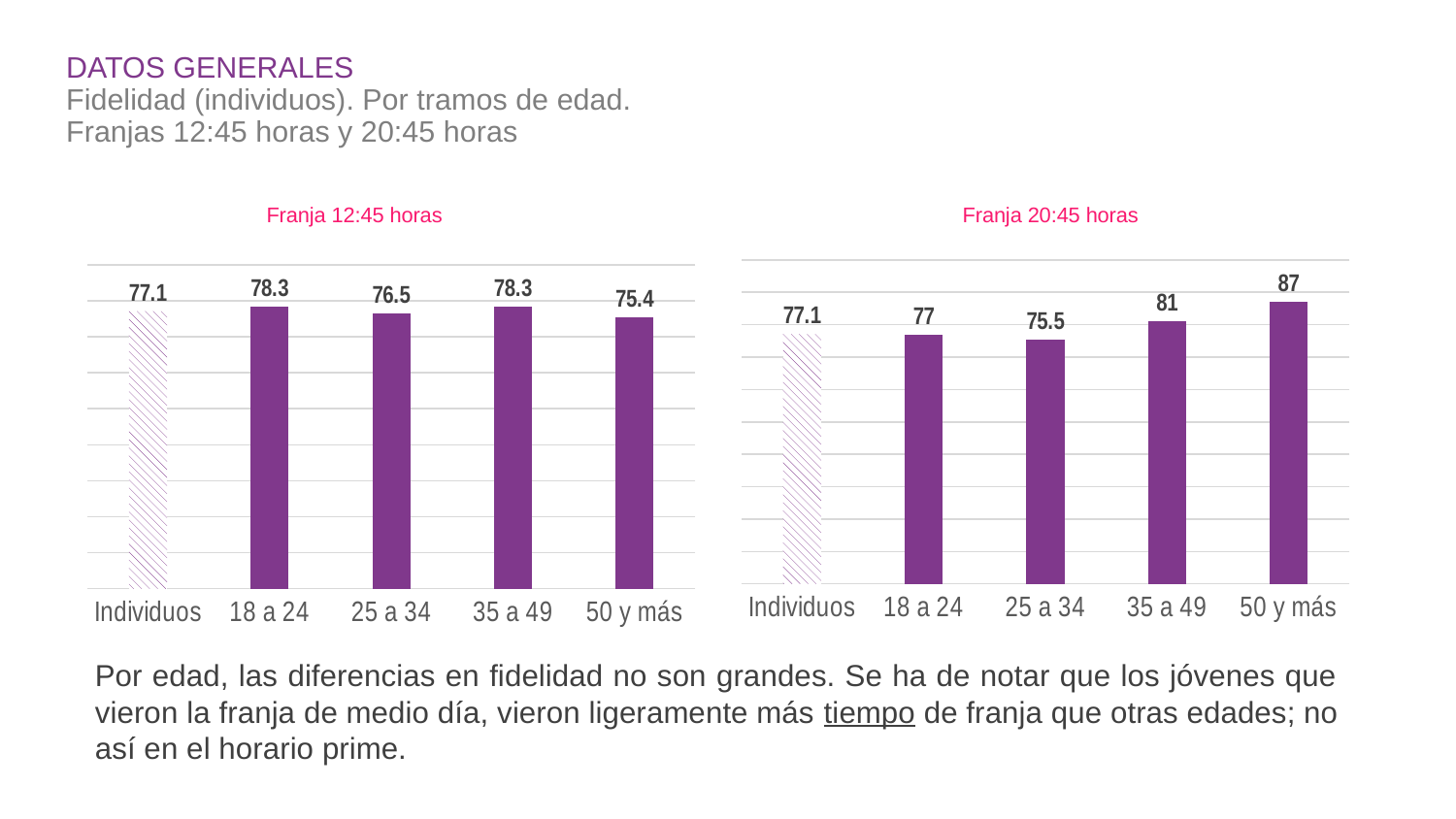
In the 'Franja 20:45 horas' chart, do the values rise or fall from 25 a 34 to 50 y más? Rise In the 'Franja 20:45 horas' chart, what is the value for 35 a 49? 81 How many categories are shown in the 'Franja 20:45 horas' chart? 5 In the 'Franja 12:45 horas' chart, which category has the lowest value? 50 y más In the 'Franja 12:45 horas' chart, what is the value for 25 a 34? 76.5 In the 'Franja 20:45 horas' chart, which category has the lowest value? 25 a 34 In the 'Franja 12:45 horas' chart, which is larger: the value for 18 a 24 or the value for 25 a 34? 18 a 24 In the 'Franja 12:45 horas' chart, what is the difference between the values for 18 a 24 and 50 y más? 2.9 What kind of chart is the 'Franja 12:45 horas' chart? Bar chart In the 'Franja 20:45 horas' chart, what is the difference between the values for 50 y más and 18 a 24? 10 In the 'Franja 20:45 horas' chart, what is the value for Individuos? 77.1 In the 'Franja 20:45 horas' chart, which category has the highest value? 50 y más